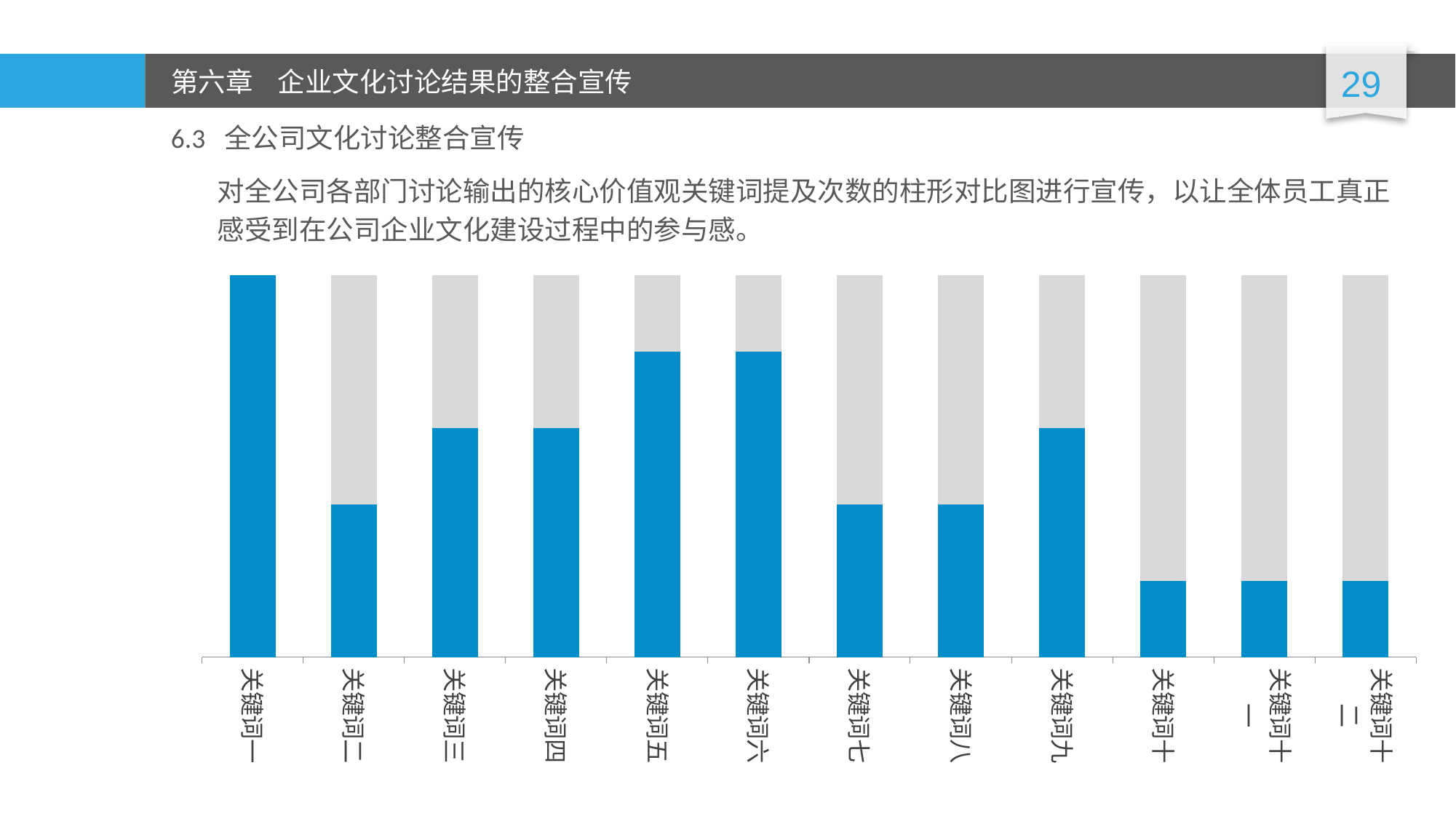
Which is larger, the value for 关键词四 or the value for 关键词十二? 关键词四 Which keyword has the highest bar in the chart? 关键词一 Which is larger, the value for 关键词九 or the value for 关键词七? 关键词九 How many categories (keywords) are shown on the x axis of the chart? 12 Which is larger, the value for 关键词六 or the value for 关键词十? 关键词六 What is the label of the first category on the x axis? 关键词一 What colour are the data bars in the chart? blue What kind of chart is shown on the slide? bar chart